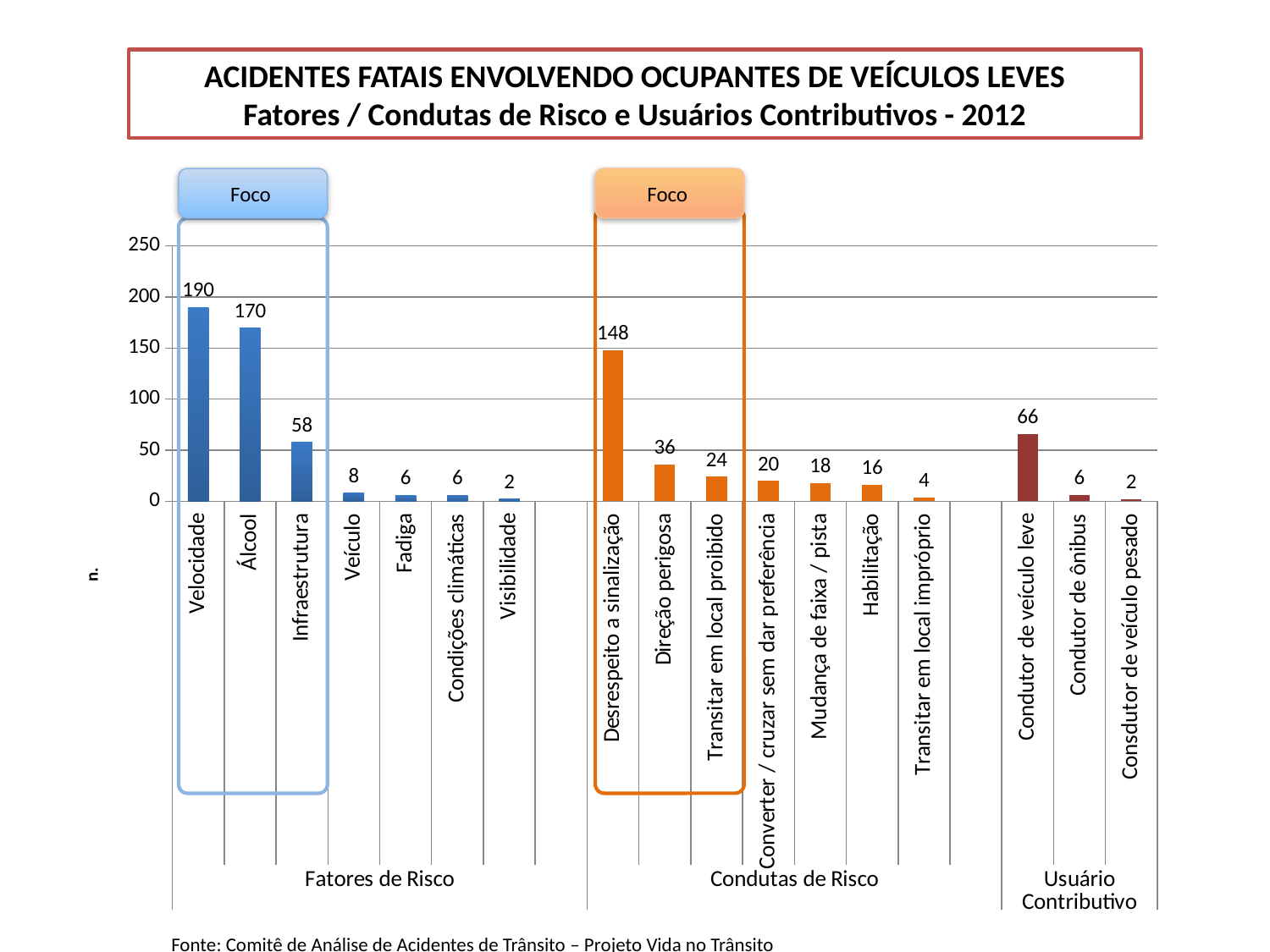
Is the value for Desrespeito a sinalização greater or less than 100? greater What is the value for Desrespeito a sinalização? 148 What year is stated in the chart title? 2012 Which is larger, the value for Infraestrutura or the value for Direção perigosa? Infraestrutura Which category in the Condutas de Risco group has the lowest value? Transitar em local impróprio How many categories are plotted in the Fatores de Risco group? 7 What kind of chart is shown on the slide? bar chart What is the value for Condutor de veículo leve? 66 Which category has the highest value on the chart? Velocidade What is the total of the values for Condutor de veículo leve, Condutor de ônibus and Consdutor de veículo pesado? 74 What is the difference between the values for Velocidade and Álcool? 20 What is the value for Velocidade? 190